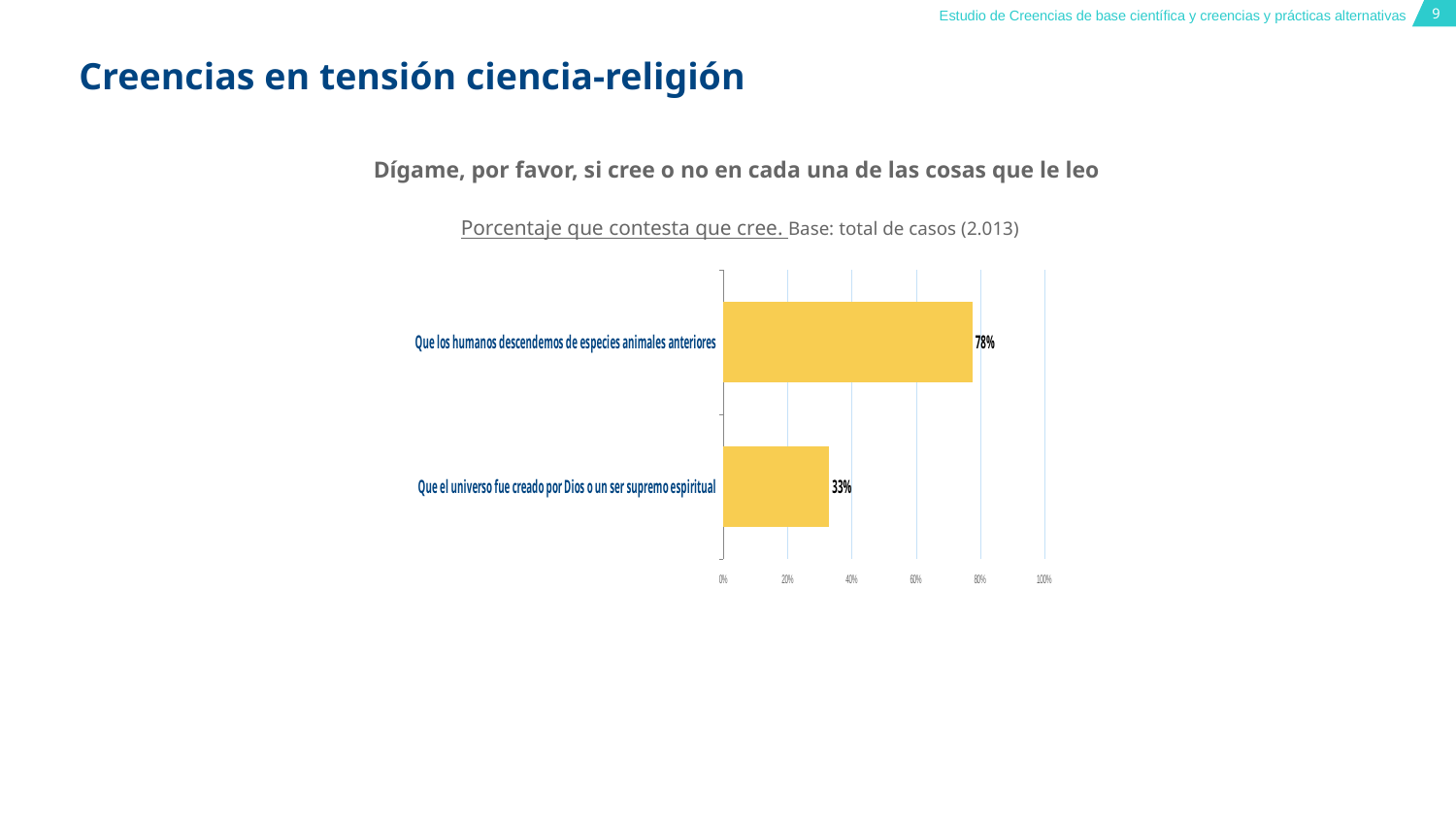
Is the value for "Que los humanos descendemos de especies animales anteriores" greater or less than 60%? greater What is the base (total number of cases) stated for the chart? 2.013 Which belief has the highest percentage of respondents saying they believe it? Que los humanos descendemos de especies animales anteriores Is the value for "Que el universo fue creado por Dios o un ser supremo espiritual" greater or less than 40%? less How many categories (beliefs) are shown in the chart? 2 Which is larger: the percentage believing humans descend from earlier animal species, or the percentage believing the universe was created by God? Que los humanos descendemos de especies animales anteriores What is the difference in percentage points between belief in human descent from earlier animal species and belief that the universe was created by God? 45 What percentage of respondents say they believe the universe was created by God or a supreme spiritual being ("Que el universo fue creado por Dios o un ser supremo espiritual")? 33% Which belief has the lowest percentage of respondents saying they believe it? Que el universo fue creado por Dios o un ser supremo espiritual What kind of chart is shown on the slide? Bar chart What percentage of respondents say they believe that humans descend from earlier animal species ("Que los humanos descendemos de especies animales anteriores")? 78% What is the maximum value shown on the chart's horizontal axis? 100%